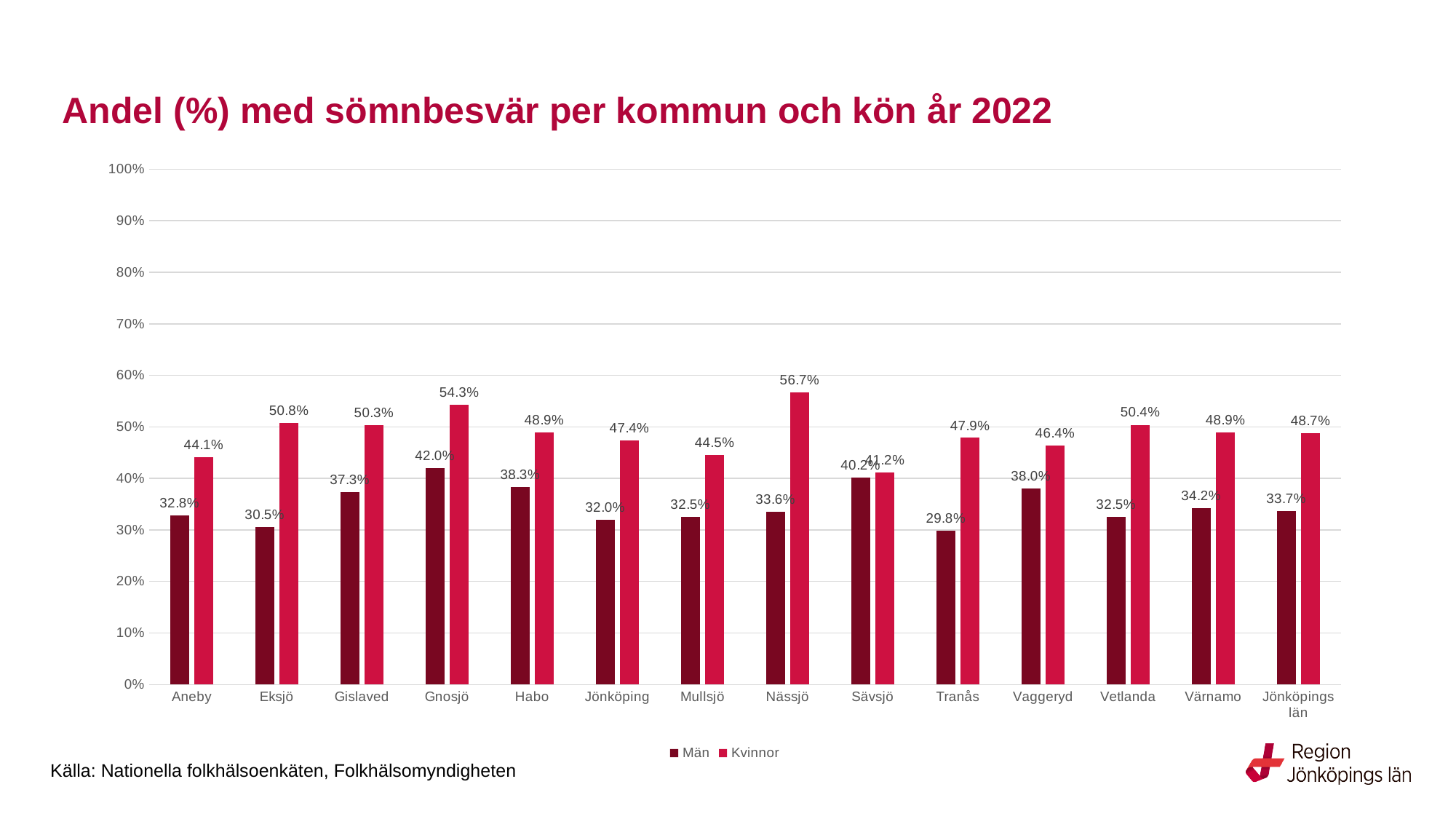
Which municipality has the lowest value for Män? Tranås What is the value for Män in Gnosjö? 42.0% Is the value for Kvinnor in Eksjö greater or less than 50%? greater How many series does the legend list? 2 What kind of chart is shown on the slide? Bar chart Which is larger in Sävsjö, the value for Män or for Kvinnor? Kvinnor How many categories are shown on the x axis? 14 Which municipality has the highest value for Kvinnor? Nässjö What is the title of the chart? Andel (%) med sömnbesvär per kommun och kön år 2022 What is the value for Män in Jönköpings län? 33.7% What is the value for Kvinnor in Nässjö? 56.7% What is the difference between the Kvinnor and Män values in Gnosjö? 12.3%